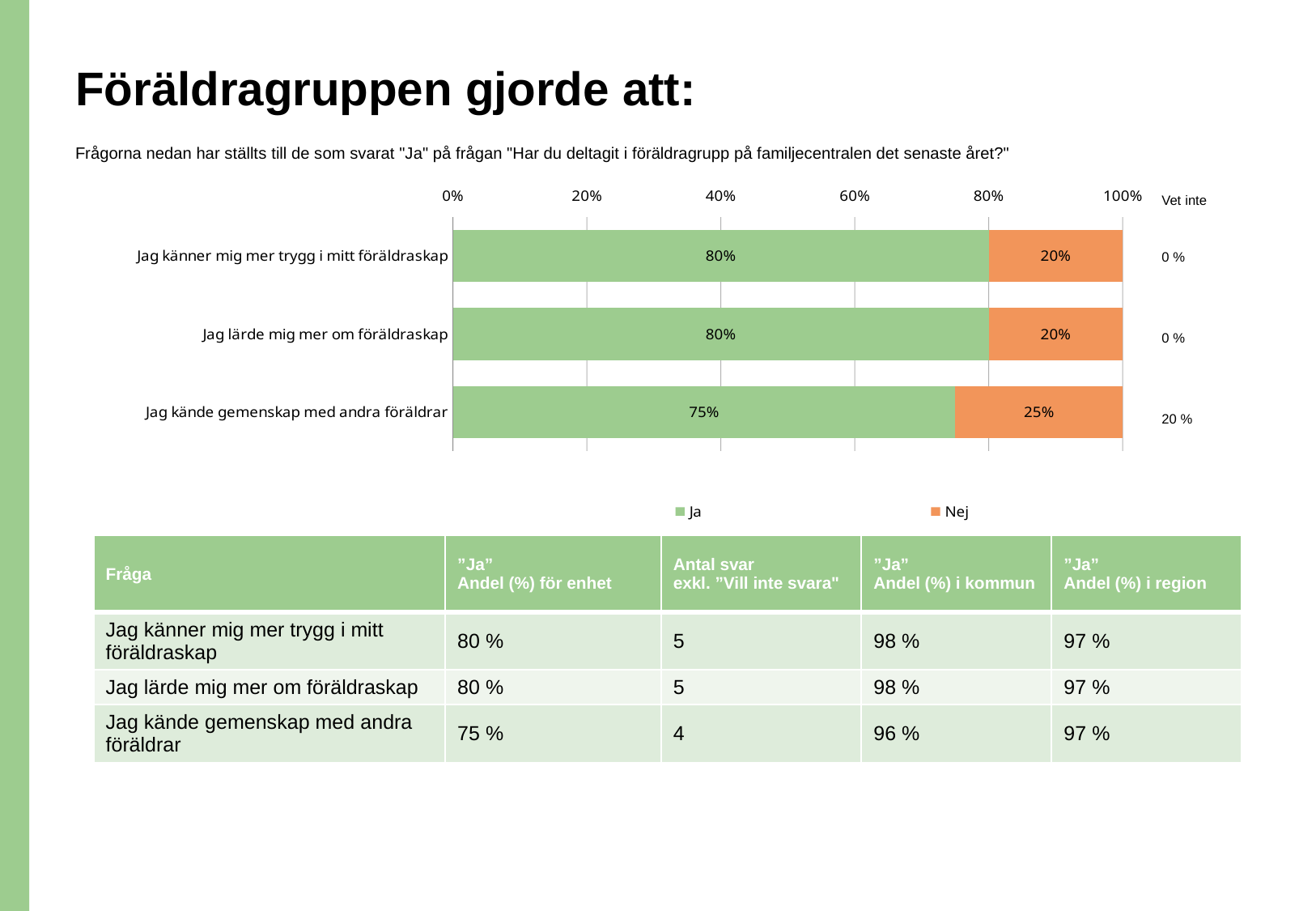
What is the total of the stacked bar for "Jag känner mig mer trygg i mitt föräldraskap"? 100% How many categories does the chart show? 3 Which category has the lowest "Ja" value? Jag kände gemenskap med andra föräldrar What is the difference between the "Ja" value for "Jag lärde mig mer om föräldraskap" and the "Ja" value for "Jag kände gemenskap med andra föräldrar"? 5% Which series is shown in orange in the chart? Nej What is the "Nej" value for "Jag kände gemenskap med andra föräldrar"? 25% What is the "Ja" value for "Jag lärde mig mer om föräldraskap"? 80% Is the "Ja" value for "Jag kände gemenskap med andra föräldrar" larger or smaller than the "Ja" value for "Jag känner mig mer trygg i mitt föräldraskap"? Smaller What is the "Ja" value for "Jag känner mig mer trygg i mitt föräldraskap"? 80% How many series does the chart legend list? 2 What kind of chart is shown on the slide? Stacked bar chart Which category has the highest "Nej" value? Jag kände gemenskap med andra föräldrar